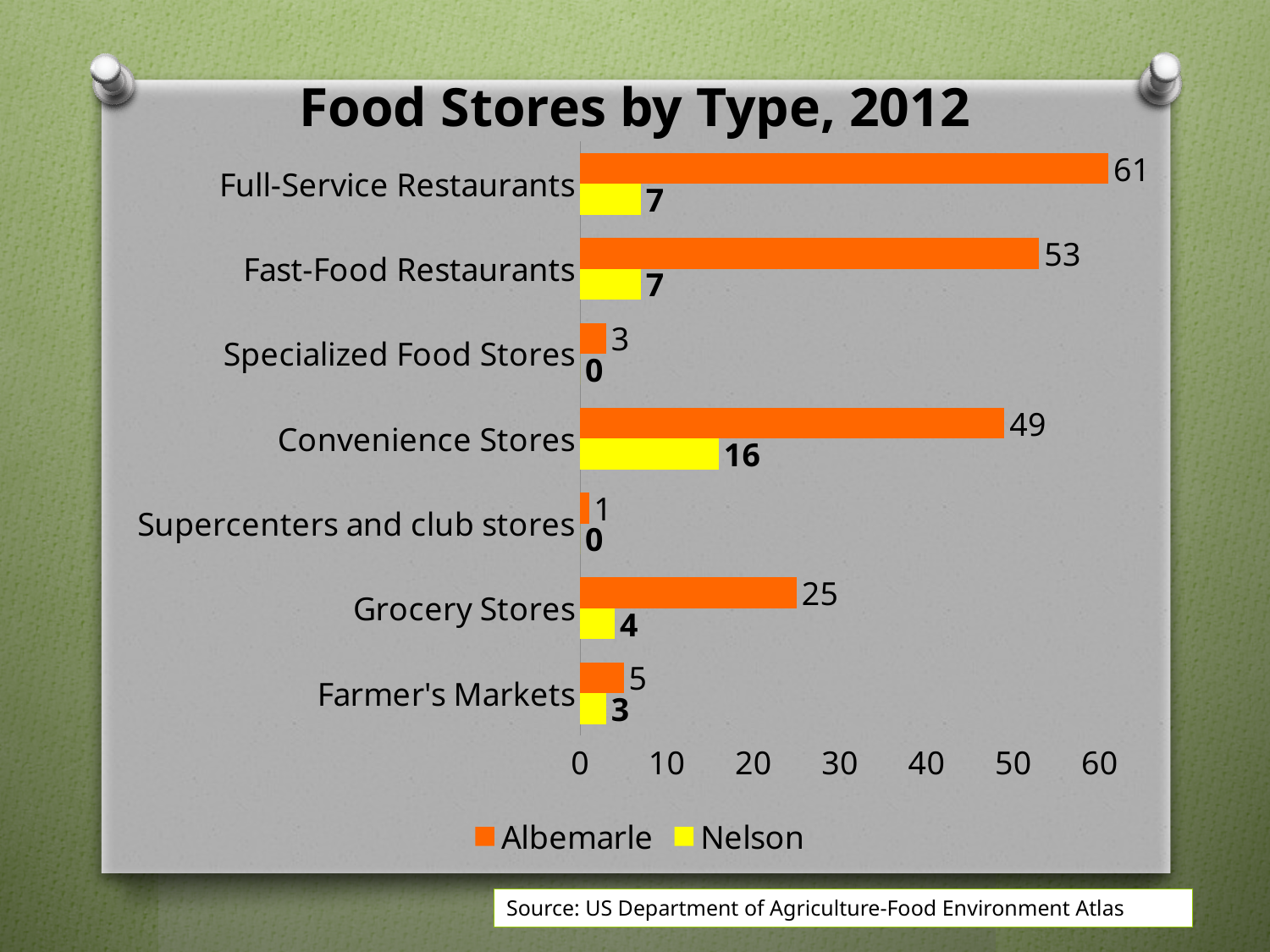
What is the difference between the Albemarle and Nelson values for Fast-Food Restaurants? 46 How many store type categories are shown on the chart? 7 Which category has the highest Albemarle value? Full-Service Restaurants Which category has the lowest Albemarle value? Supercenters and club stores What is the value for Albemarle for Grocery Stores? 25 Which is larger: the Albemarle value for Convenience Stores or the Albemarle value for Fast-Food Restaurants? Fast-Food Restaurants What kind of chart is shown on the slide? bar chart What is the value for Albemarle for Full-Service Restaurants? 61 How many series does the legend list? 2 Is the Albemarle value for Convenience Stores greater or less than 40? greater What is the title of the chart? Food Stores by Type, 2012 What is the value for Nelson for Convenience Stores? 16